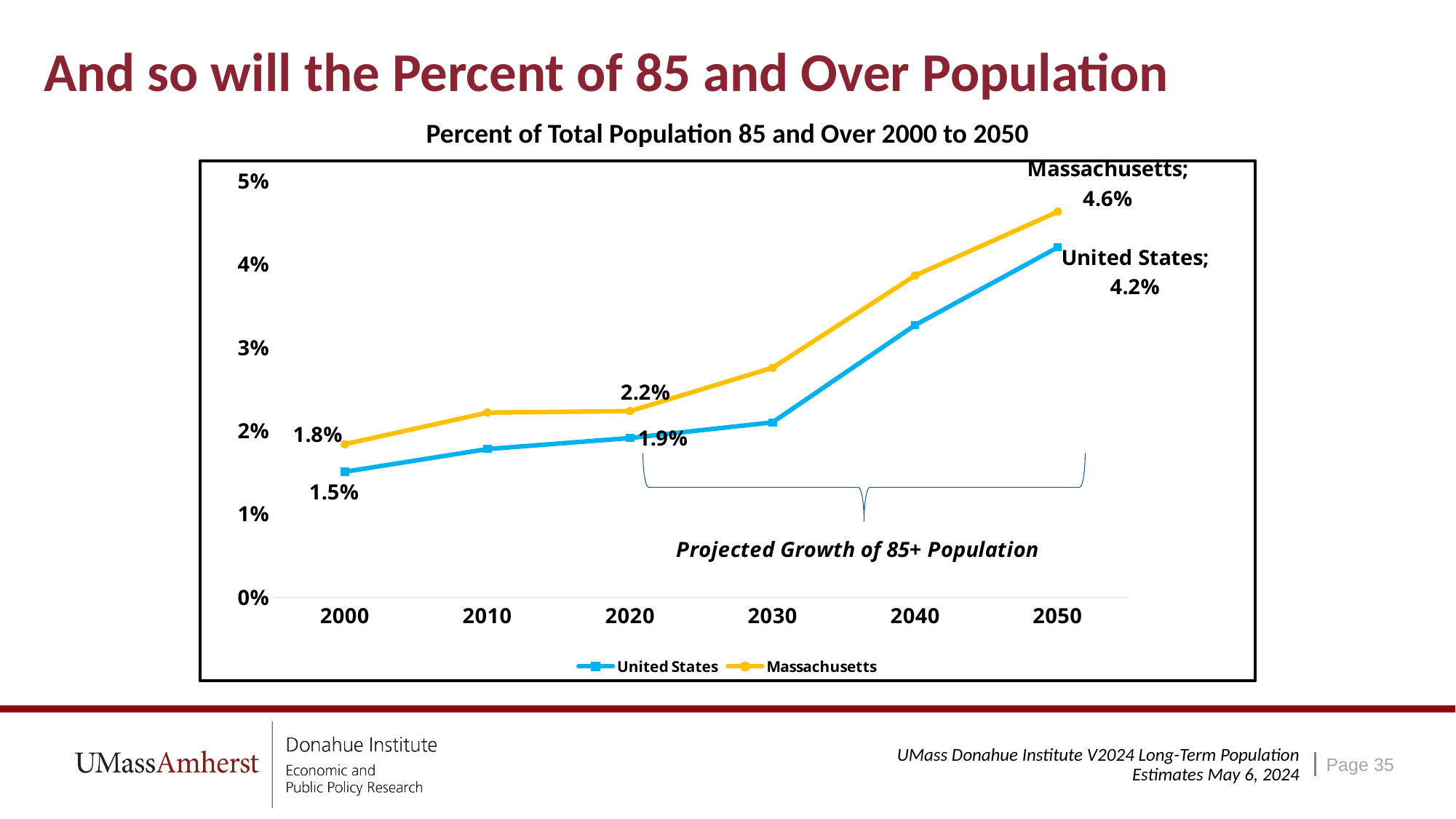
How many years are shown on the x axis? 6 What is the title of the chart? Percent of Total Population 85 and Over 2000 to 2050 What is the value for the United States in 2000? 1.5% What is the difference between the Massachusetts and United States values in 2050? 0.4% What kind of chart is shown on the slide? line chart Do the values for the United States rise or fall from 2000 to 2050? rise Which series has the higher value in 2000, United States or Massachusetts? Massachusetts What is the value for Massachusetts in 2050? 4.6% How many series does the legend list? 2 What is the value for the United States in 2050? 4.2% What is the value for Massachusetts in 2020? 2.2% Is the value for Massachusetts in 2040 greater or less than 3%? greater